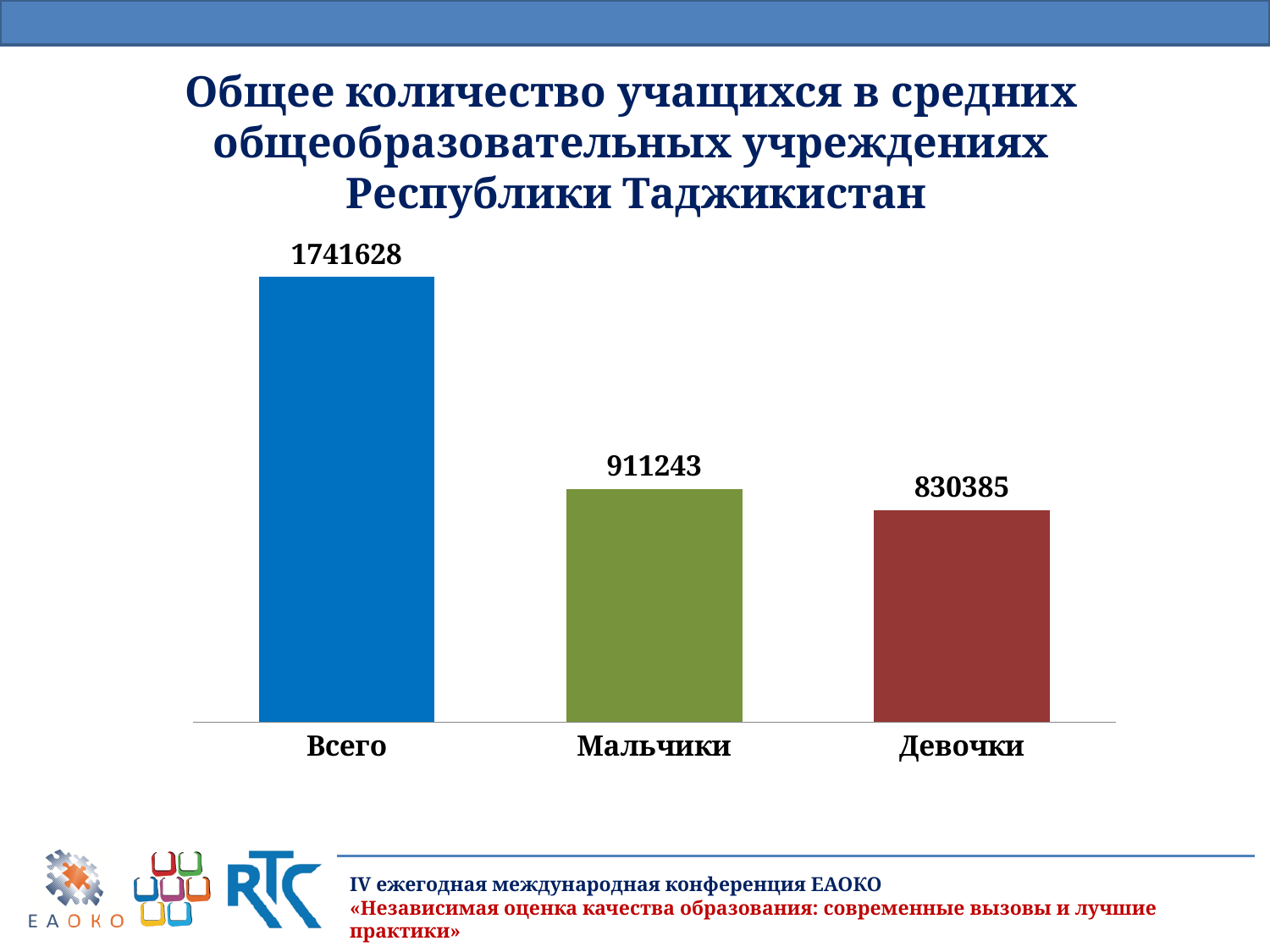
Which category has the lowest value? Девочки What is the difference between the values for Мальчики and Девочки? 80858 What is the value shown for Всего? 1741628 Which category has the highest value? Всего What kind of chart is shown on the slide? Bar chart What is the value shown for Мальчики? 911243 How many categories are shown on the chart? 3 What is the difference between the values for Всего and Мальчики? 830385 Which is larger, the value for Мальчики or the value for Девочки? Мальчики What is the value shown for Девочки? 830385 What colour is the bar for Мальчики? Green Do the values rise or fall from left to right across the categories? Fall